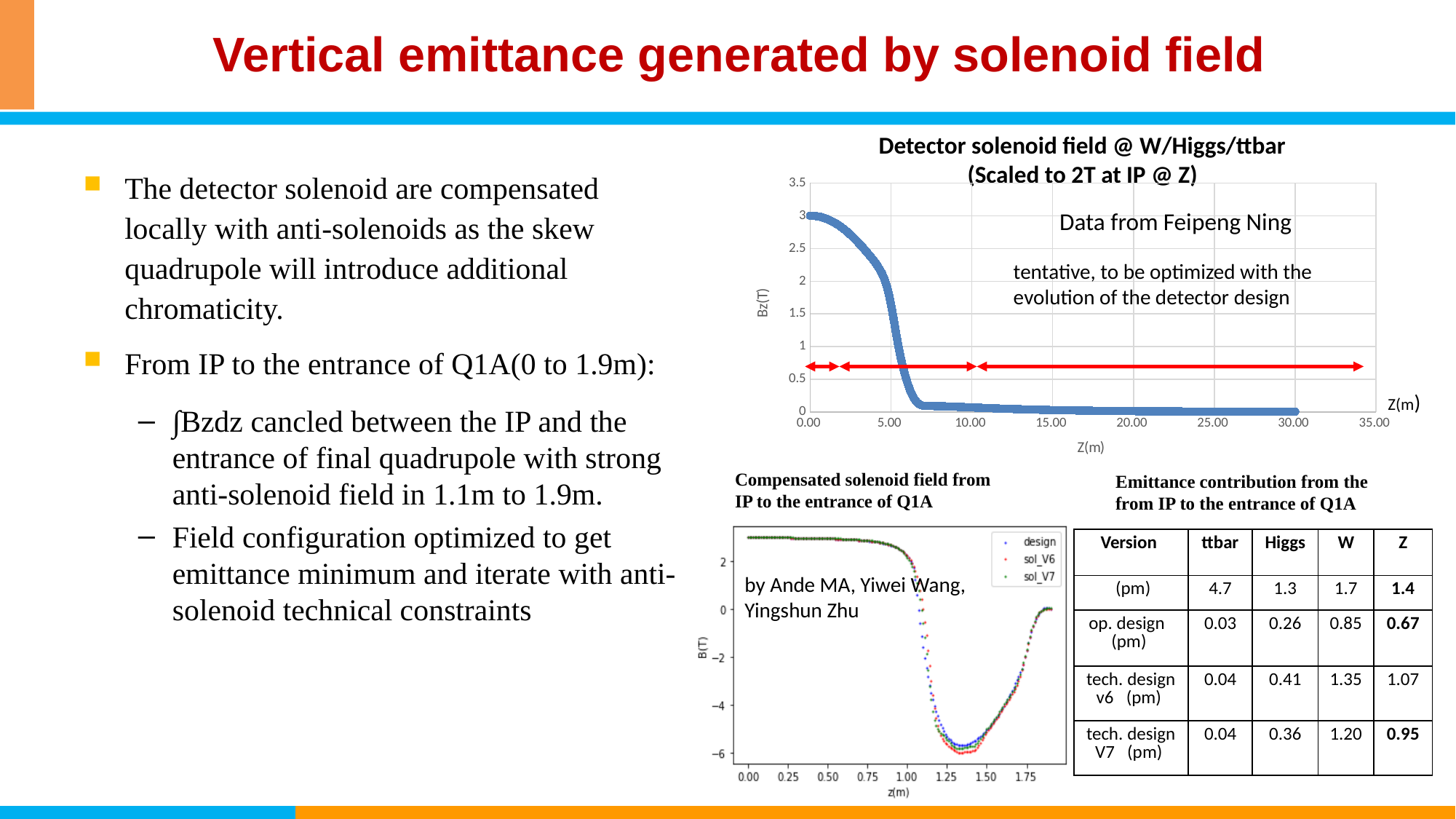
In the top-right chart 'Detector solenoid field @ W/Higgs/ttbar', do the Bz values rise or fall as Z increases? fall What kind of chart is the top-right chart titled 'Detector solenoid field @ W/Higgs/ttbar'? scatter plot How many series does the legend list in the bottom chart 'Compensated solenoid field from IP to the entrance of Q1A'? 3 In the bottom chart 'Compensated solenoid field from IP to the entrance of Q1A', is the B value at z = 1.25 greater or less than -4? less In the top-right chart 'Detector solenoid field @ W/Higgs/ttbar', is the Bz value at Z = 0.00 greater or less than 2? greater In the bottom chart 'Compensated solenoid field from IP to the entrance of Q1A', is the B value at z = 0.50 greater or less than 2? greater In the bottom chart 'Compensated solenoid field from IP to the entrance of Q1A', what is the label of the horizontal axis? z(m) What are the legend entries in the bottom chart 'Compensated solenoid field from IP to the entrance of Q1A'? design, sol_V6, sol_V7 In the top-right chart 'Detector solenoid field @ W/Higgs/ttbar', what is the label of the vertical axis? Bz(T) What kind of chart is the bottom chart 'Compensated solenoid field from IP to the entrance of Q1A'? scatter plot